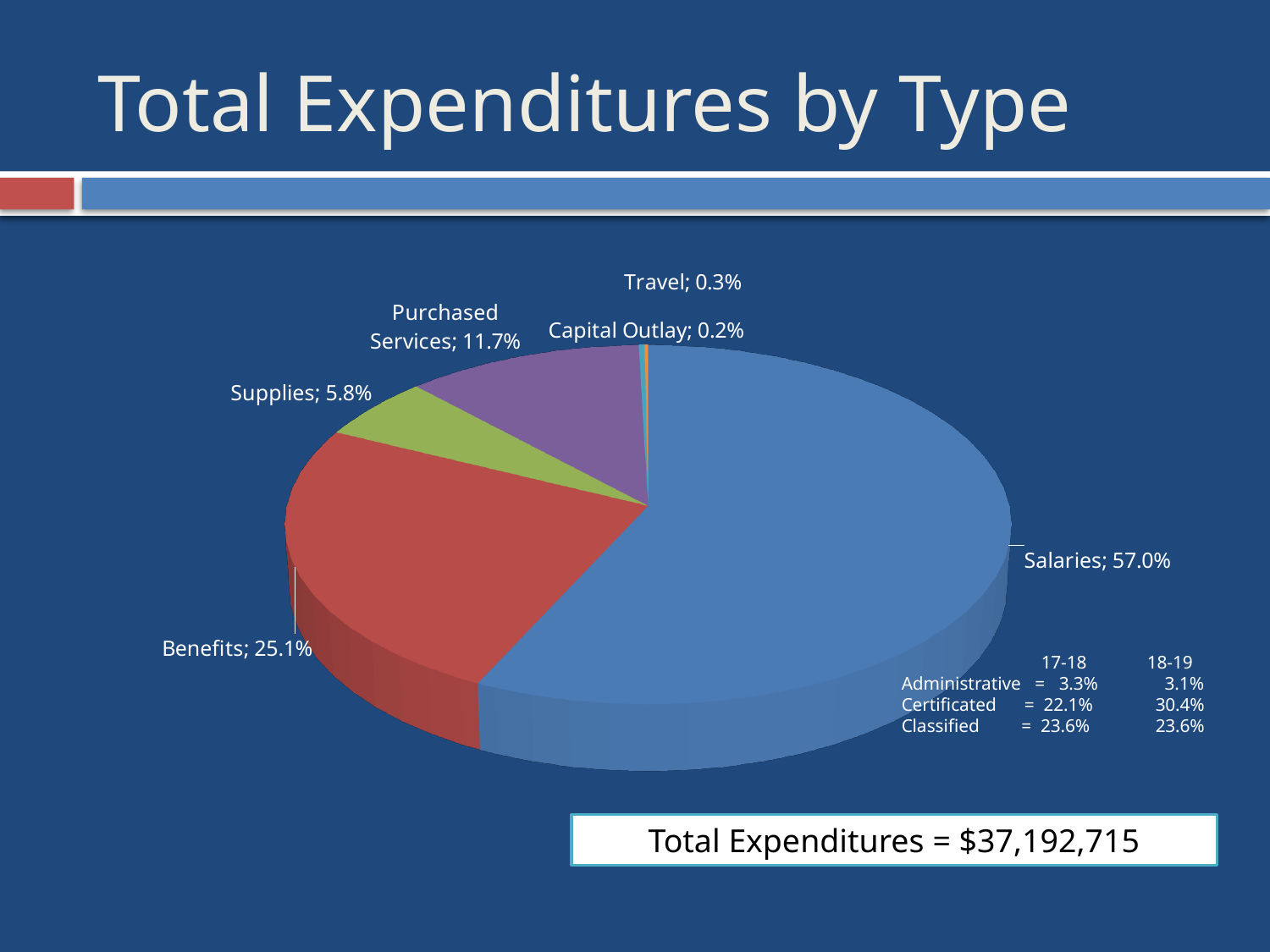
What is the title of the slide containing the chart? Total Expenditures by Type How many expenditure types are shown in the pie chart? 6 What share of total expenditures is Purchased Services? 11.7% What share of total expenditures is Salaries? 57.0% What share of total expenditures is Benefits? 25.1% What share of total expenditures is Capital Outlay? 0.2% What kind of chart is shown on the slide? Pie chart What is the difference in percentage points between Salaries and Benefits? 31.9 What share of total expenditures is Supplies? 5.8% Which expenditure type has the largest share of the pie? Salaries Which expenditure type has the smallest share of the pie? Capital Outlay Which is larger, the share for Supplies or the share for Purchased Services? Purchased Services